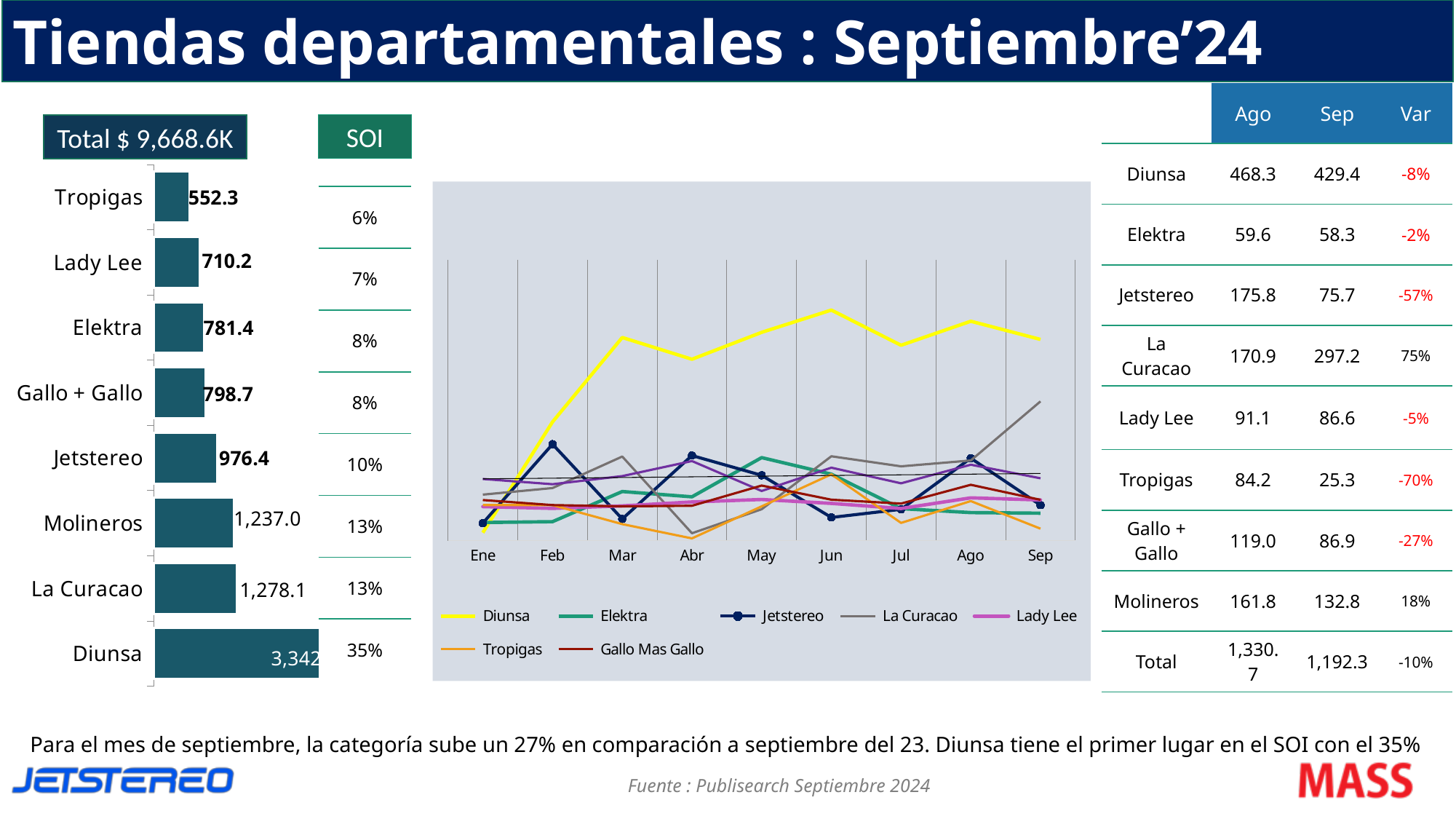
In the bar chart on the left, which store has the highest value? Diunsa In the bar chart on the left, what is the value for Molineros? 1,237.0 In the bar chart on the left, what is the value for Tropigas? 552.3 In the bar chart on the left, which store has the lowest value? Tropigas How many stores are shown in the bar chart on the left? 8 How many series does the legend of the line chart in the center list? 7 In the bar chart on the left, which is larger, Elektra or Lady Lee? Elektra What type of chart is the chart on the left? bar chart In the bar chart on the left, what is the difference between La Curacao and Molineros? 41.1 In the line chart in the center, which series has the highest values from Mar to Sep? Diunsa In the bar chart on the left, what is the value for Jetstereo? 976.4 How many months are shown on the x axis of the line chart in the center? 9